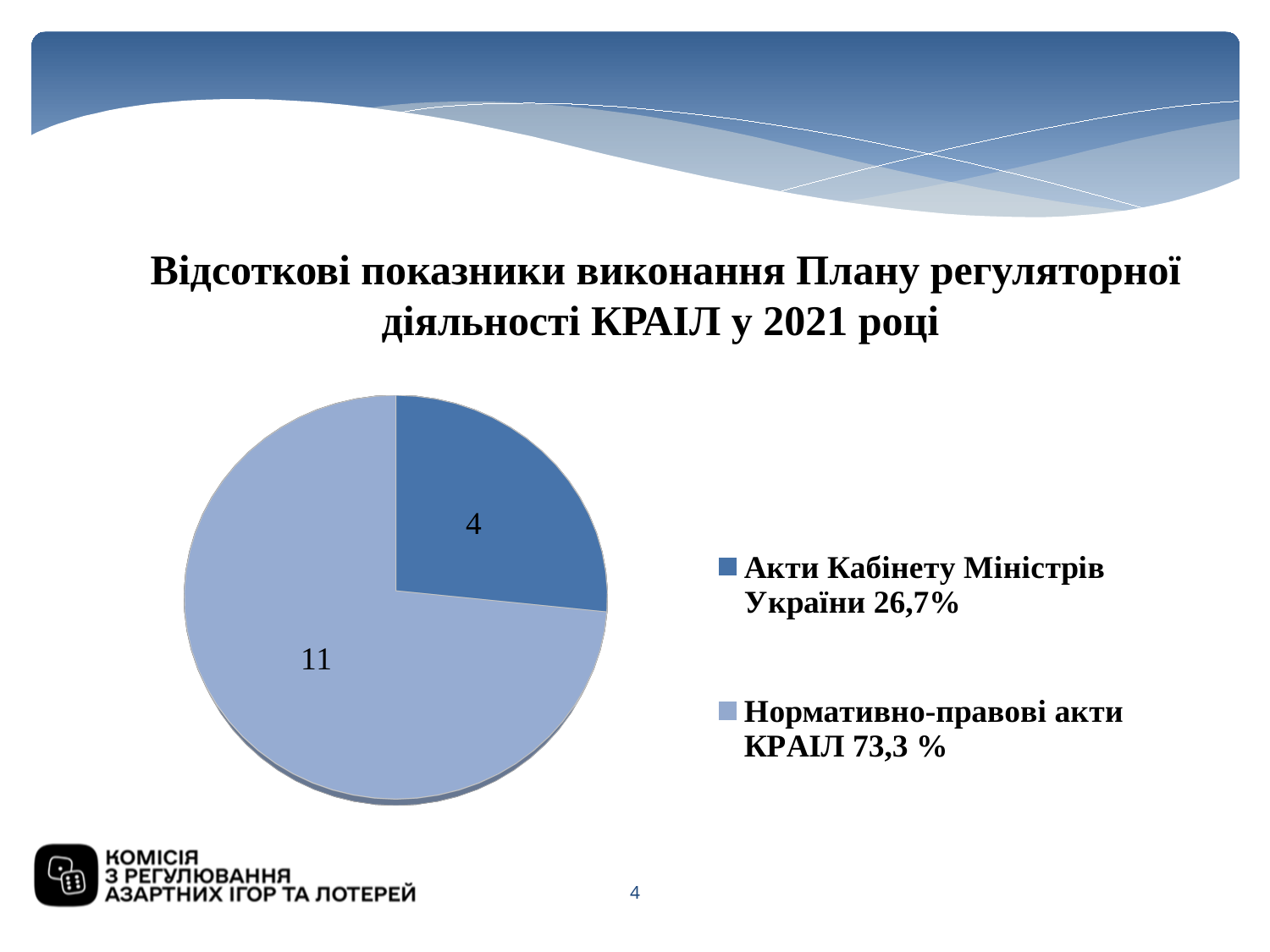
What is the difference between the value for Нормативно-правові акти КРАІЛ and the value for Акти Кабінету Міністрів України? 7 Which is larger: the value for Акти Кабінету Міністрів України or the value for Нормативно-правові акти КРАІЛ? Нормативно-правові акти КРАІЛ What is the total of the two values shown on the pie chart? 15 What type of chart is shown on the slide? pie chart What share of the pie does Нормативно-правові акти КРАІЛ represent, as shown in the legend? 73,3 % What is the value for Нормативно-правові акти КРАІЛ? 11 What is the value for Акти Кабінету Міністрів України? 4 Which category has the largest slice of the pie? Нормативно-правові акти КРАІЛ Which category has the smallest slice of the pie? Акти Кабінету Міністрів України What is the title of the chart on the slide? Відсоткові показники виконання Плану регуляторної діяльності КРАІЛ у 2021 році How many slices does the pie chart have? 2 What share of the pie does Акти Кабінету Міністрів України represent, as shown in the legend? 26,7%